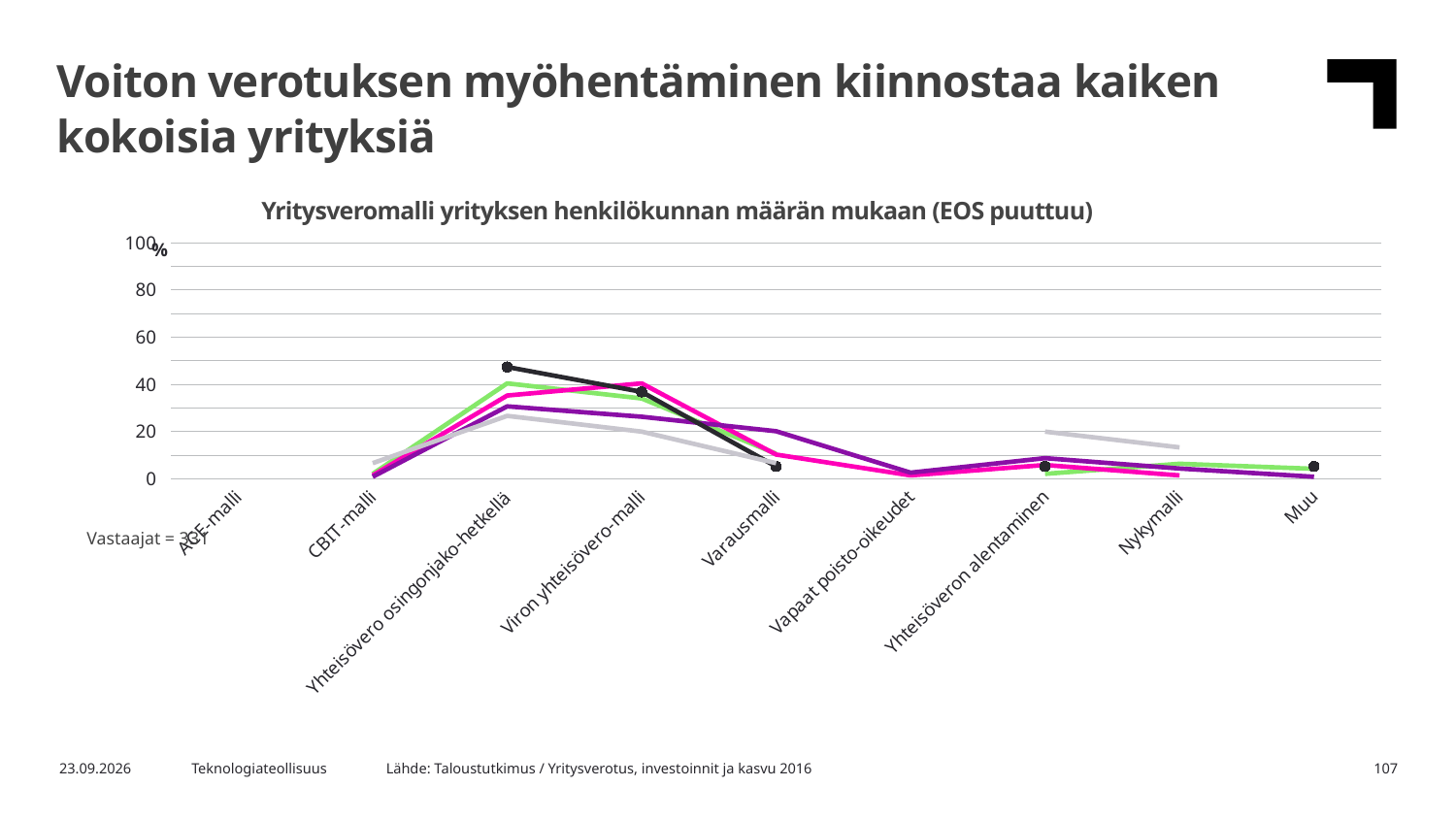
Is the value of the black line for Varausmalli greater or less than 20? less Is the value of the gray line for Nykymalli greater or less than 20? less Do the lines rise or fall between CBIT-malli and Yhteisövero osingonjako-hetkellä? rise Is the value of the pink line for Vapaat poisto-oikeudet greater or less than 20? less What is the title of the chart? Yritysveromalli yrityksen henkilökunnan määrän mukaan (EOS puuttuu) How many categories are shown on the x axis of the chart? 9 Do the lines rise or fall between Varausmalli and Vapaat poisto-oikeudet? fall Which category has the highest peak across the lines in the chart? Yhteisövero osingonjako-hetkellä What kind of chart is shown on the slide? line chart For the black line, which is larger: the value for Yhteisövero osingonjako-hetkellä or the value for Varausmalli? Yhteisövero osingonjako-hetkellä What is the highest value shown on the y axis of the chart? 100